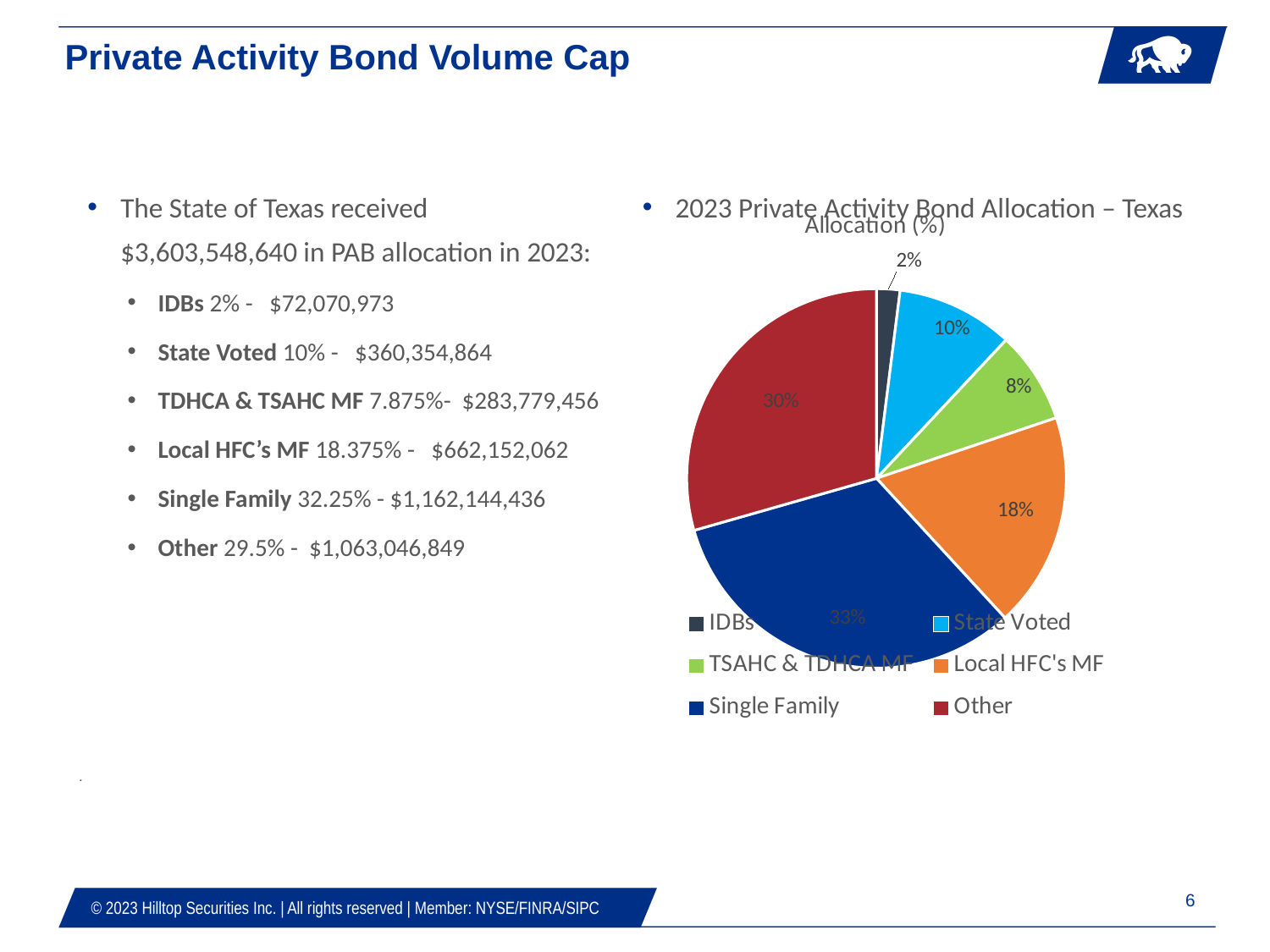
What is the title of the chart? Allocation (%) Which category has the smallest slice of the pie? IDBs Which category has the largest slice of the pie? Single Family What is the difference in percentage points between the Other slice and the Local HFC's MF slice? 12 What percentage does the Local HFC's MF slice show? 18% What kind of chart is shown on the slide? pie chart How many slices does the pie chart have? 6 Which legend entry is shown in orange? Local HFC's MF Which slice is larger, State Voted or TSAHC & TDHCA MF? State Voted What percentage does the Other slice show? 30% What percentage does the State Voted slice show? 10% What percentage does the IDBs slice show? 2%